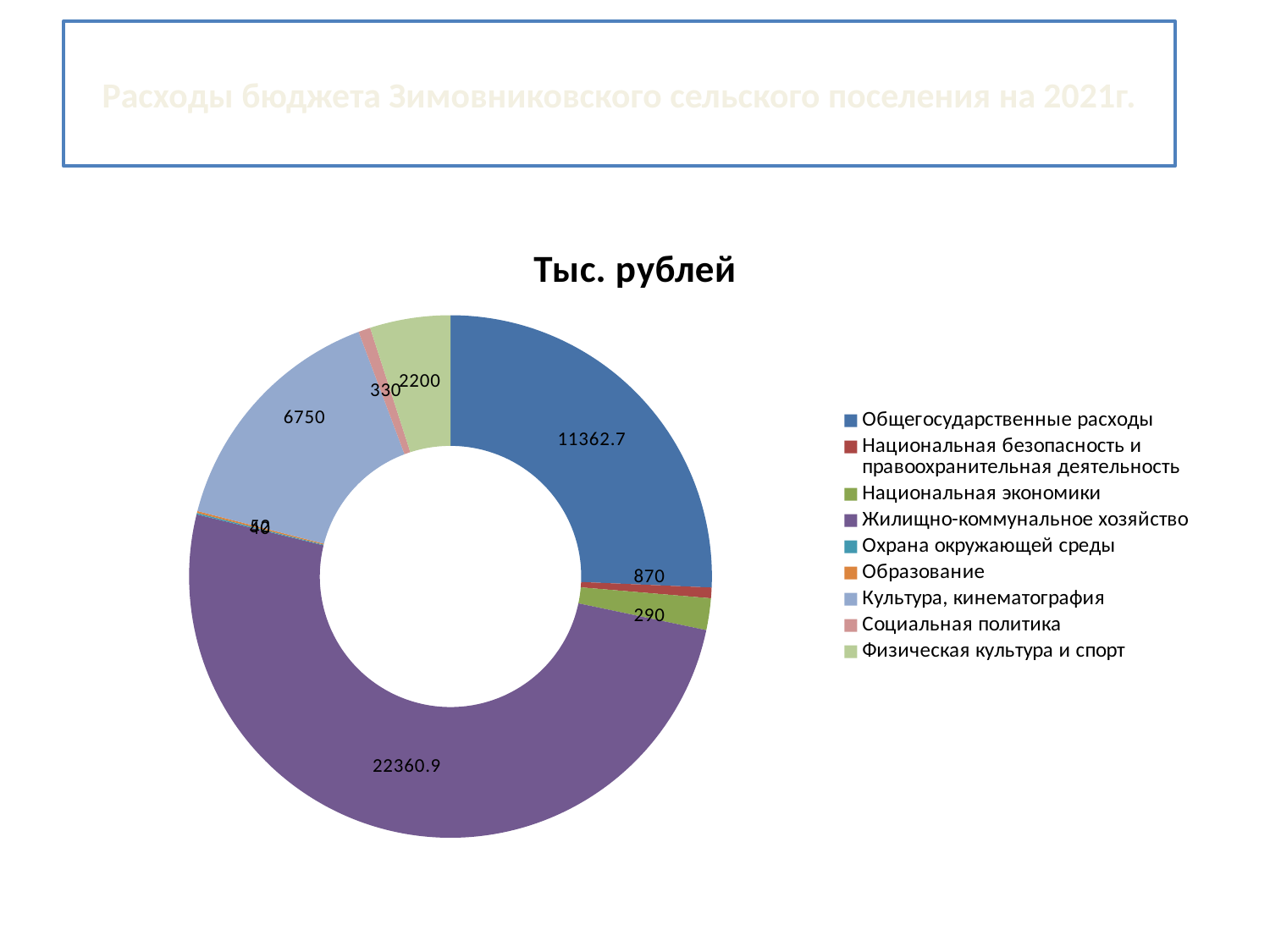
How many categories does the legend list? 9 What is the value for Социальная политика? 330 What is the value for Культура, кинематография? 6750 Which is larger, Национальная экономики or Социальная политика? Национальная экономики What is the difference between Жилищно-коммунальное хозяйство and Общегосударственные расходы? 10998.2 Which category has the largest value? Жилищно-коммунальное хозяйство What is the value for Общегосударственные расходы? 11362.7 What is the value for Физическая культура и спорт? 2200 What is the value for Жилищно-коммунальное хозяйство? 22360.9 What is the value for Национальная безопасность и правоохранительная деятельность? 290 What is the title of the chart? Тыс. рублей What kind of chart is shown on the slide? Doughnut (pie) chart